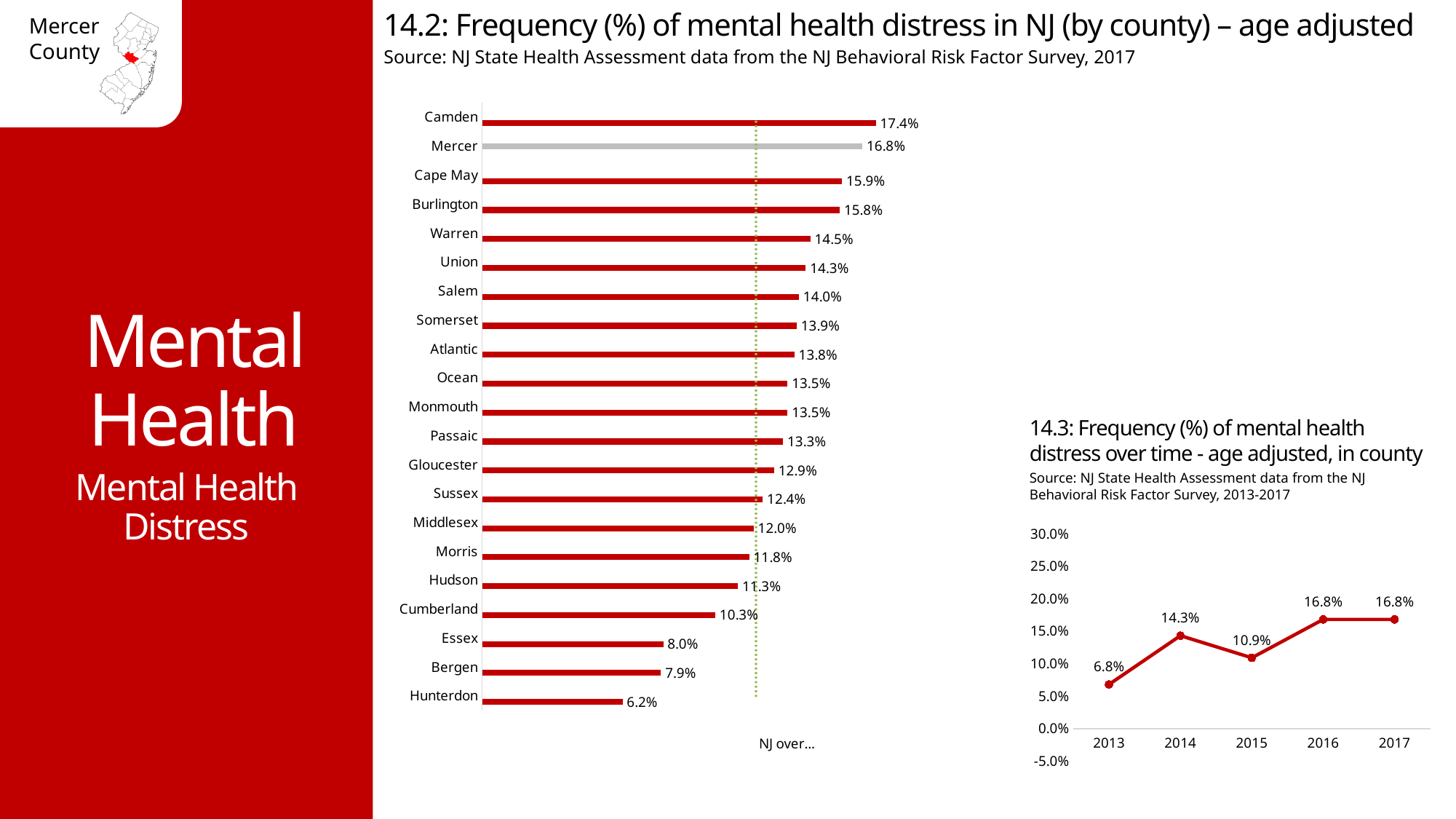
In the chart 14.3 (over time), what is the value for 2013? 6.8% What kind of chart is chart 14.2 (by county)? Bar chart In the chart 14.3 (over time), which year has the lowest value? 2013 In the chart 14.2 (by county), what is the value for Mercer? 16.8% In the chart 14.3 (over time), what is the difference between 2014 and 2015? 3.4% In the chart 14.2 (by county), how many counties are shown? 21 In the chart 14.3 (over time), how many years are plotted? 5 In the chart 14.2 (by county), which county has the highest value? Camden In the chart 14.2 (by county), what is the difference between Camden and Hunterdon? 11.2% In the chart 14.2 (by county), which is larger, the value for Essex or the value for Cumberland? Cumberland In the chart 14.2 (by county), what is the value for Gloucester? 12.9% In the chart 14.2 (by county), which county has the lowest value? Hunterdon